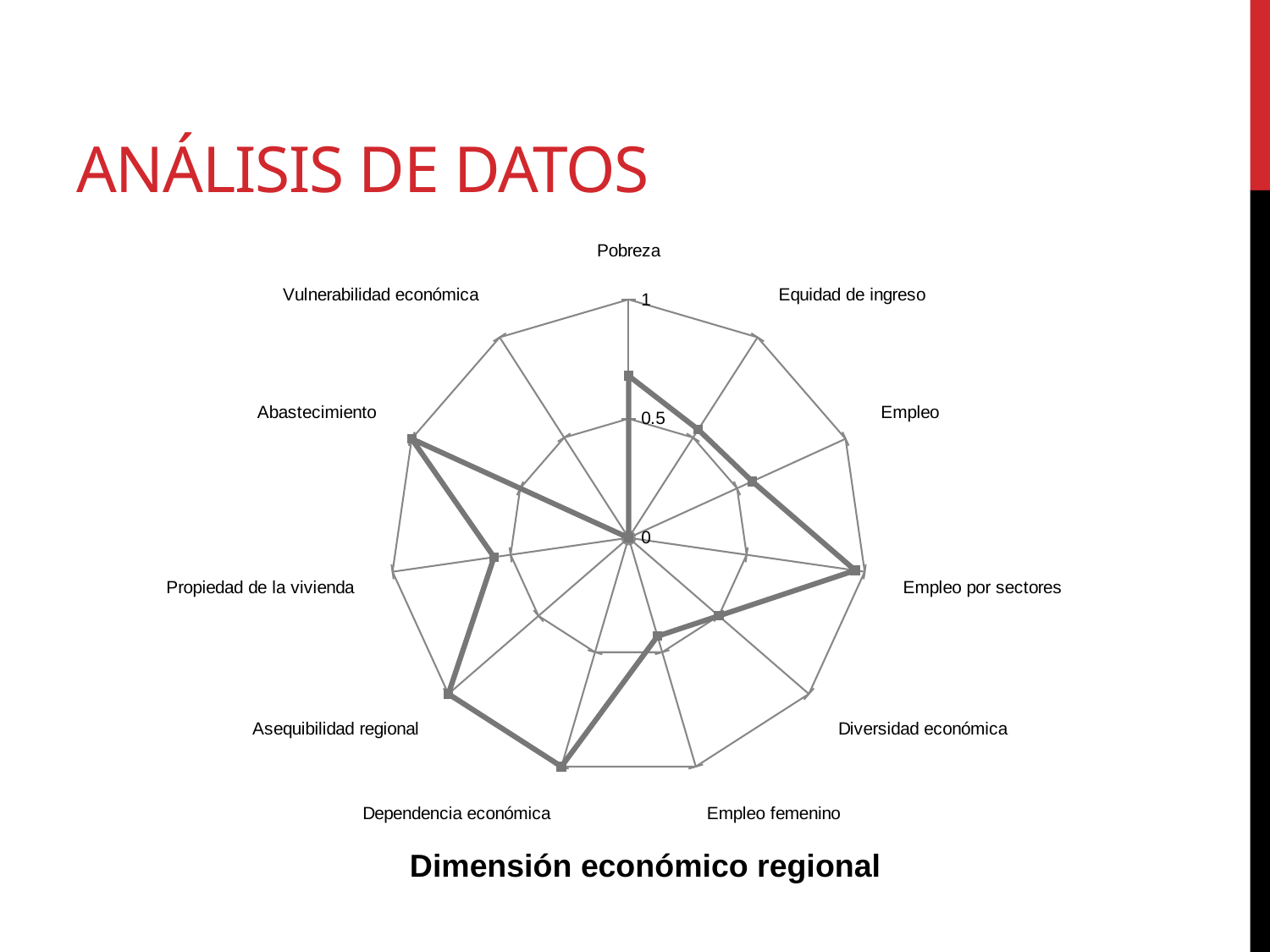
Is the value for Propiedad de la vivienda greater or less than 0.5? greater What is the value for Dependencia económica? 1 Which has the larger value, Empleo por sectores or Empleo femenino? Empleo por sectores How many categories (axes) does the radar chart have? 11 Which has the larger value, Pobreza or Diversidad económica? Pobreza Which has the larger value, Abastecimiento or Propiedad de la vivienda? Abastecimiento Is the value for Pobreza greater or less than 0.5? greater What kind of chart is shown on the slide? radar chart Is the value for Empleo femenino greater or less than 0.5? less What is the title of the chart? Dimensión económico regional